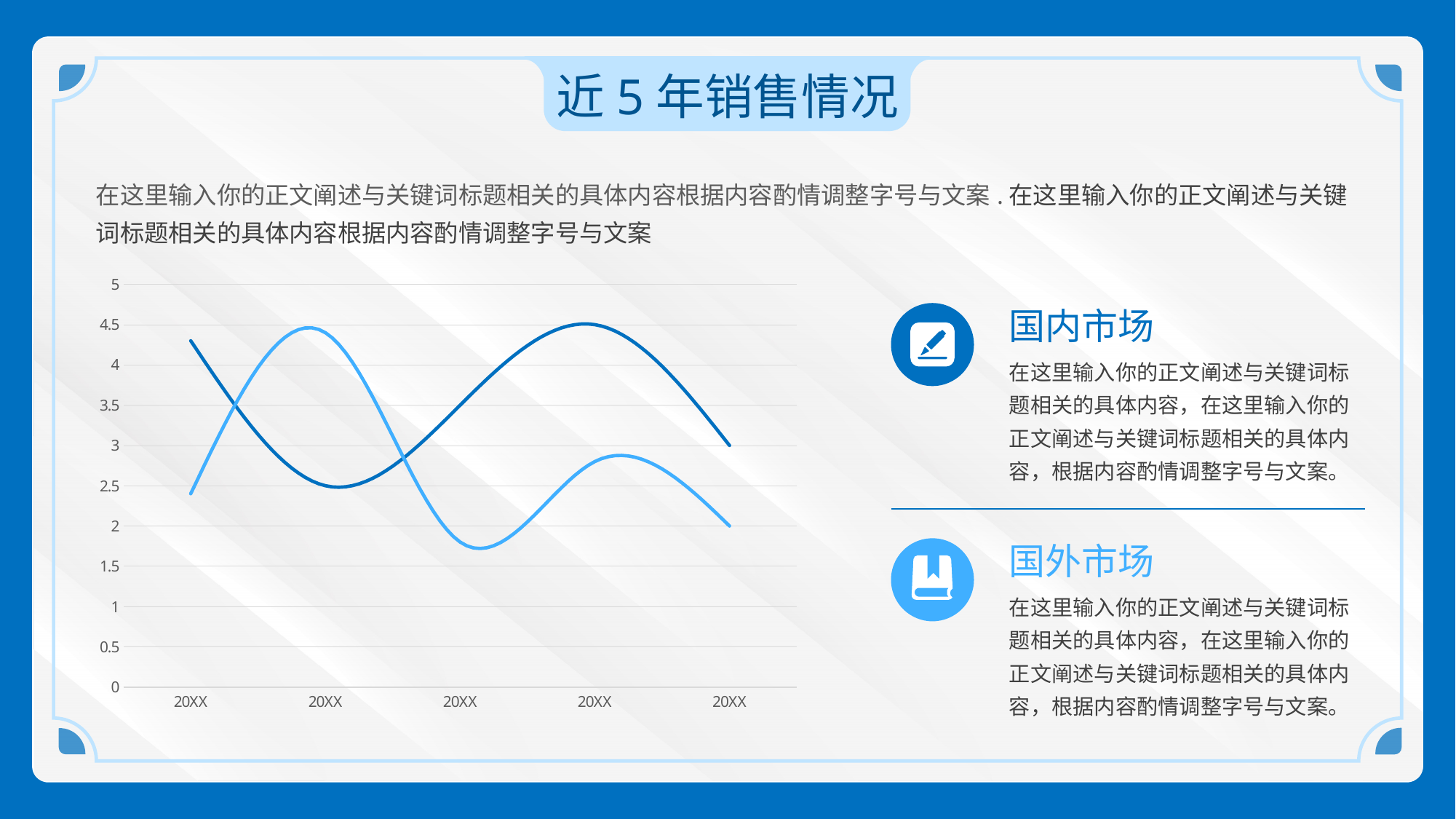
Is the value of the light blue line at the second x-axis point greater or less than 4? greater Is the value of the light blue line at the first x-axis point greater or less than 3? less What kind of chart is shown on the slide? line chart How many points are there along the x axis of the chart? 5 Is the value of the dark blue line at the first x-axis point greater or less than 4? greater What is the title of the slide containing the chart? 近 5 年销售情况 How many lines are plotted on the chart? 2 At the second x-axis point, which line is higher, the dark blue line or the light blue line? the light blue line At the first x-axis point, which line is higher, the dark blue line or the light blue line? the dark blue line At which x-axis point does the light blue line reach its highest value? the second point